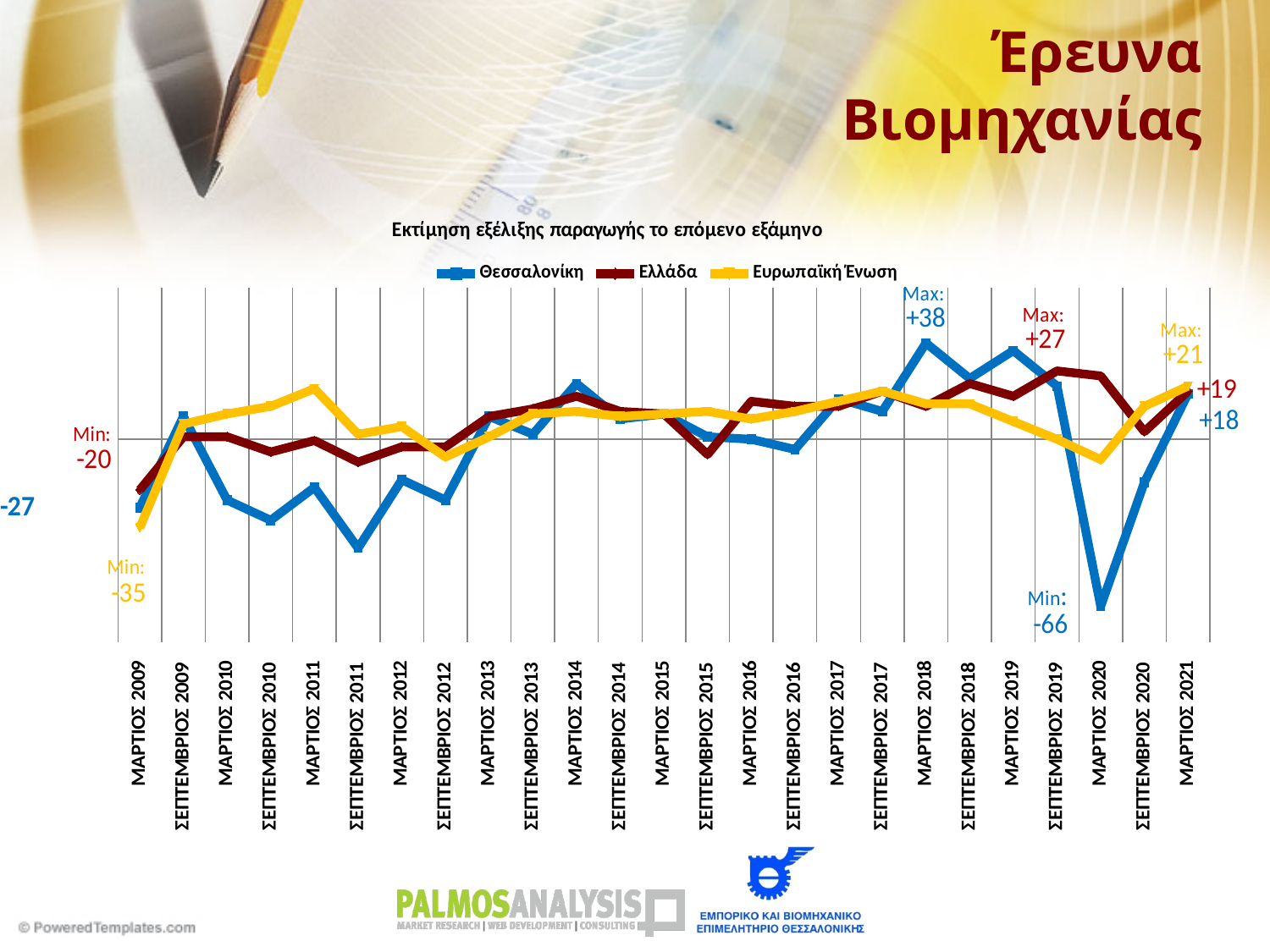
At ΜΑΡΤΙΟΣ 2009, which is larger: the Ελλάδα value or the Ευρωπαϊκή Ένωση value? Ελλάδα What is the minimum value reached by the Θεσσαλονίκη series? -66 At ΜΑΡΤΙΟΣ 2021, what is the difference between the Ευρωπαϊκή Ένωση value (+21) and the Ελλάδα value (+19)? 2 What is the maximum value reached by the Θεσσαλονίκη series? +38 What kind of chart is shown on the slide? Line chart What is the minimum value reached by the Ευρωπαϊκή Ένωση series? -35 What is the value of the Θεσσαλονίκη series at ΜΑΡΤΙΟΣ 2009? -27 How many time points are shown on the x axis? 25 What is the value of the Ευρωπαϊκή Ένωση series at ΜΑΡΤΙΟΣ 2021? +21 How many series does the legend list? 3 What is the title of the chart? Εκτίμηση εξέλιξης παραγωγής το επόμενο εξάμηνο What is the maximum value reached by the Ελλάδα series? +27